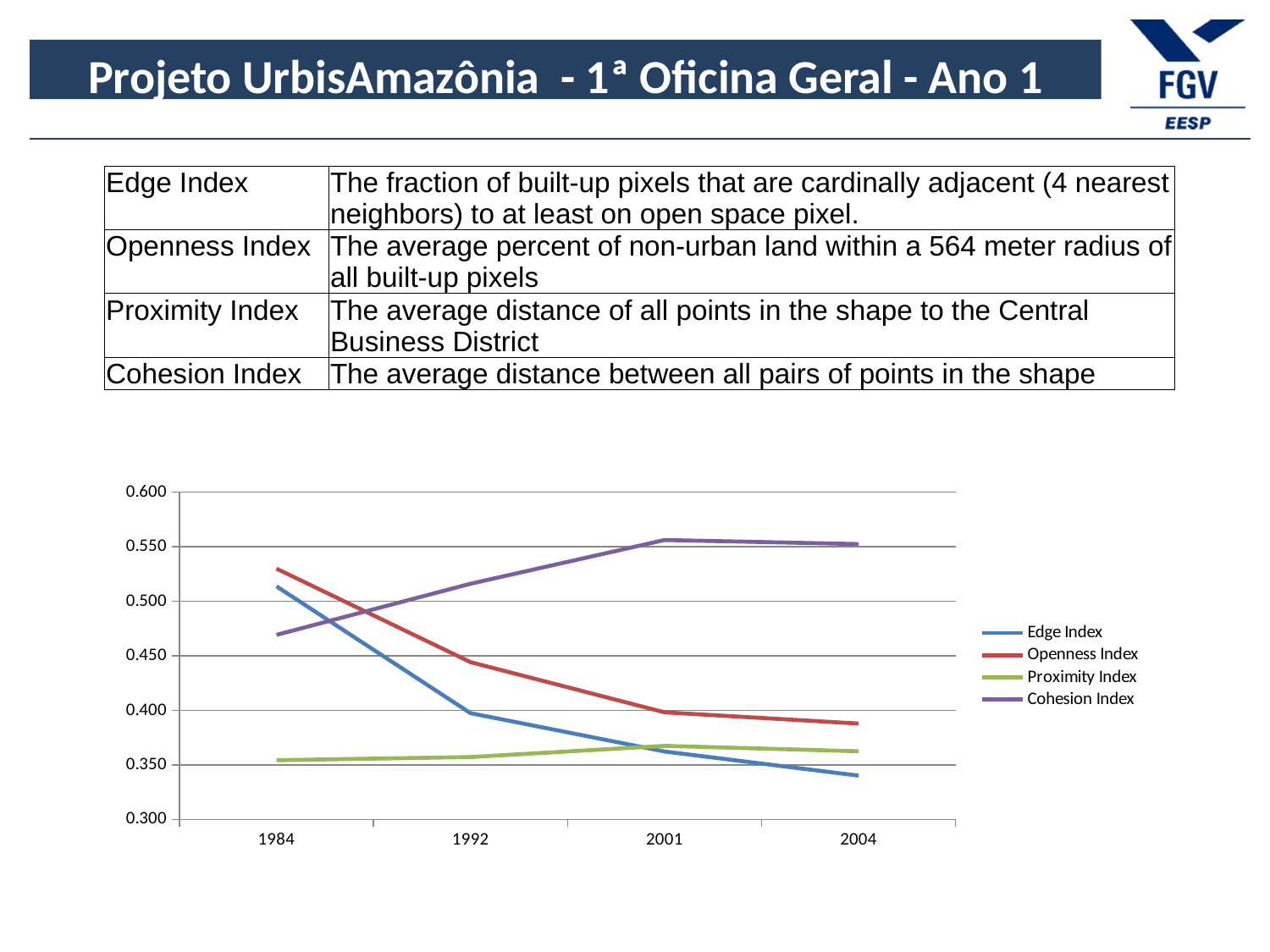
Does the Edge Index rise or fall from 1984 to 2004? fall Is the value of the Cohesion Index in 2001 greater or less than 0.500? greater How many series does the chart legend list? 4 Does the Cohesion Index rise or fall between 1984 and 2001? rise Which series has the highest value in 2004? Cohesion Index In 2004, which is larger: the Openness Index or the Cohesion Index? Cohesion Index Is the value of the Openness Index in 1984 greater or less than 0.500? greater Which series has the lowest value in 1984? Proximity Index What kind of chart is shown on the slide? line chart How many years are shown on the x axis of the chart? 4 Is the value of the Proximity Index in 1984 greater or less than 0.400? less